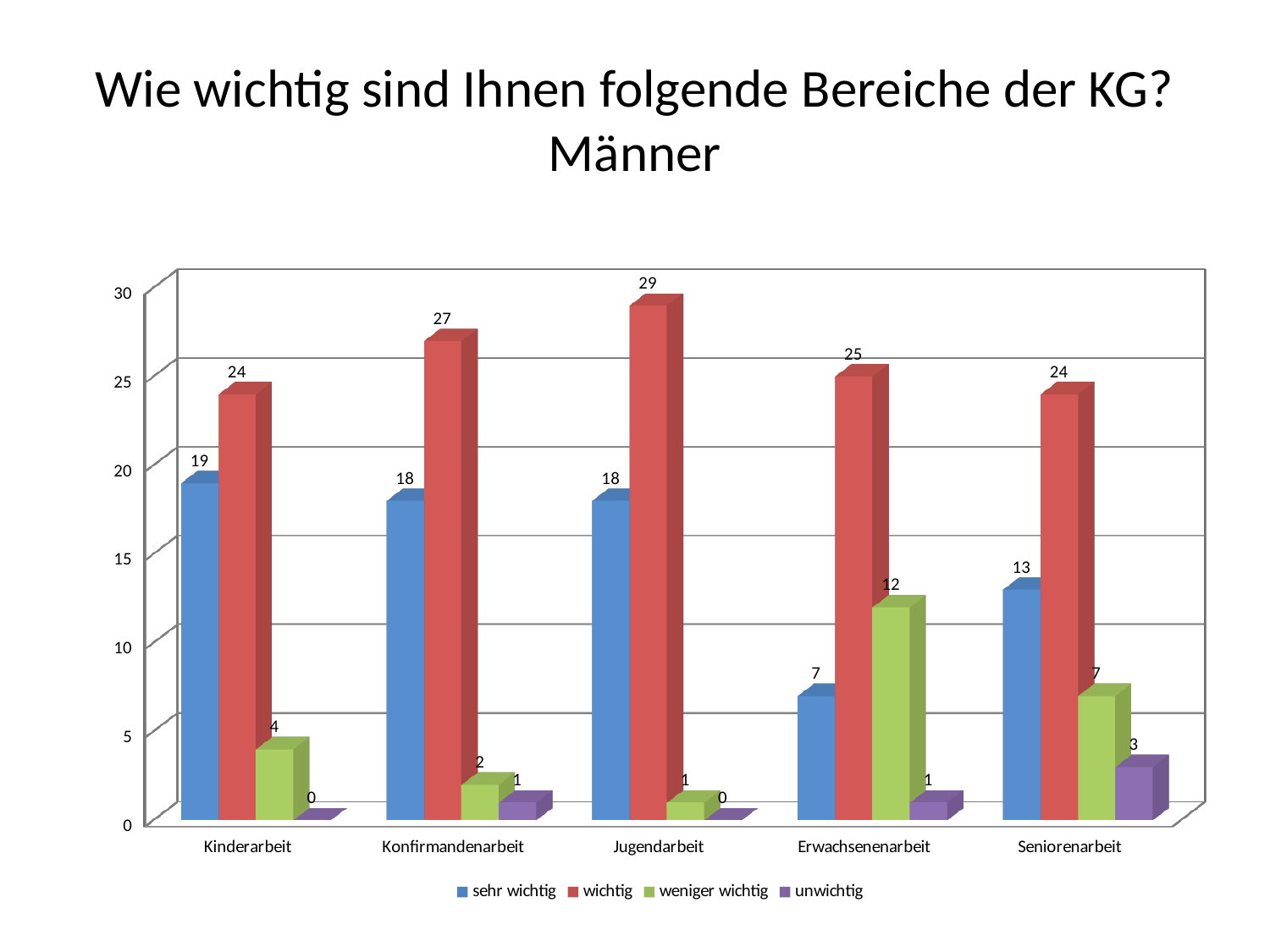
What is the value for "wichtig" in the Jugendarbeit category? 29 What is the value for "unwichtig" in the Kinderarbeit category? 0 Which category has the lowest value for "sehr wichtig"? Erwachsenenarbeit Which is larger for Seniorenarbeit: "weniger wichtig" or "unwichtig"? weniger wichtig Which category has the highest value for "wichtig"? Jugendarbeit What is the value for "sehr wichtig" in the Seniorenarbeit category? 13 Which colour represents the "unwichtig" series in the legend? Purple How many categories are shown on the x axis? 5 What kind of chart is shown on the slide? Bar chart What is the difference between the "wichtig" and "sehr wichtig" values for Konfirmandenarbeit? 9 How many series does the legend list? 4 What is the value for "weniger wichtig" in the Erwachsenenarbeit category? 12